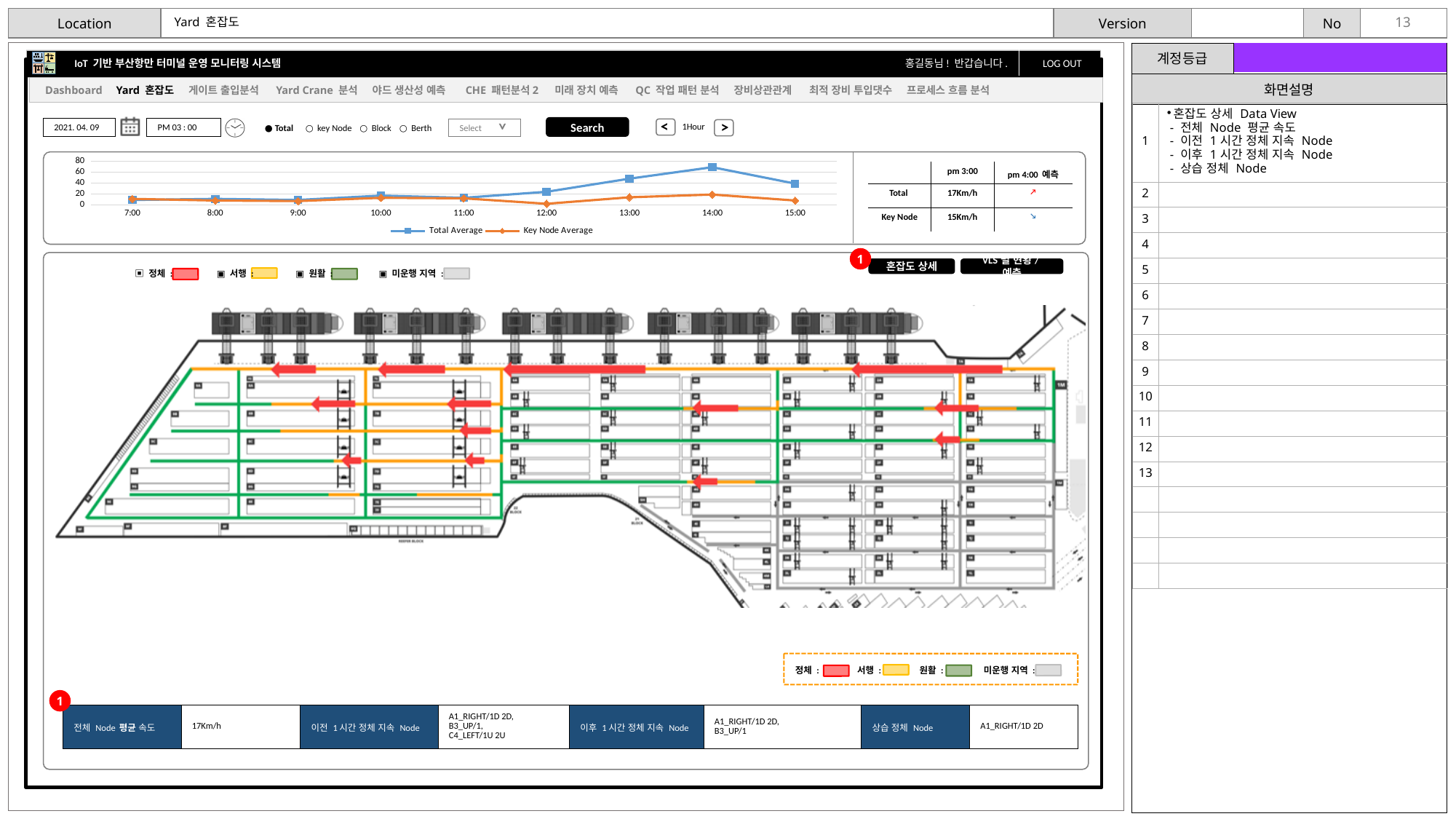
How many time points are plotted along the x axis of the line chart? 9 What colour is the Key Node Average line in the chart? orange Is the Key Node Average value at 12:00 greater or less than 20? less At 14:00, which series has the larger value, Total Average or Key Node Average? Total Average Is the Total Average value at 8:00 greater or less than 40? less What are the two series names shown in the line chart legend? Total Average, Key Node Average Does the Total Average series rise or fall between 12:00 and 14:00? rise How many series does the legend of the line chart list? 2 Does the Total Average series rise or fall between 14:00 and 15:00? fall At which time does the Total Average series reach its highest value? 14:00 What kind of chart is shown at the top of the dashboard? line chart Is the Total Average value at 14:00 greater or less than 40? greater